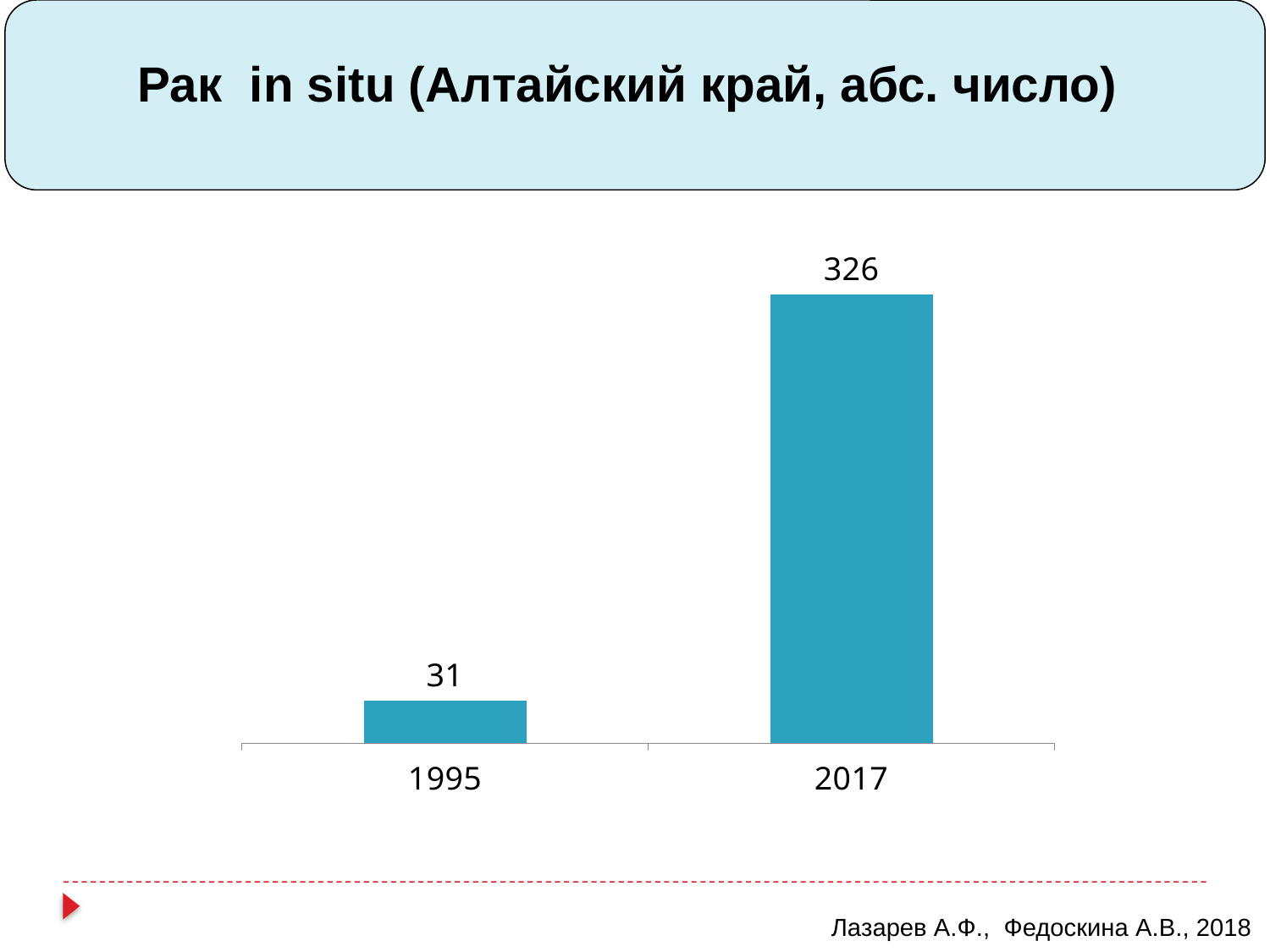
What colour are the bars in the chart? blue Do the values rise or fall from 1995 to 2017? rise What is the value for 1995? 31 Which year has the highest value? 2017 Which is larger, the value for 1995 or the value for 2017? 2017 What is the title of the slide? Рак in situ (Алтайский край, абс. число) How many categories are shown on the x axis? 2 Which year has the lowest value? 1995 What is the value for 2017? 326 What is the difference between the values for 2017 and 1995? 295 What kind of chart is shown on the slide? bar chart